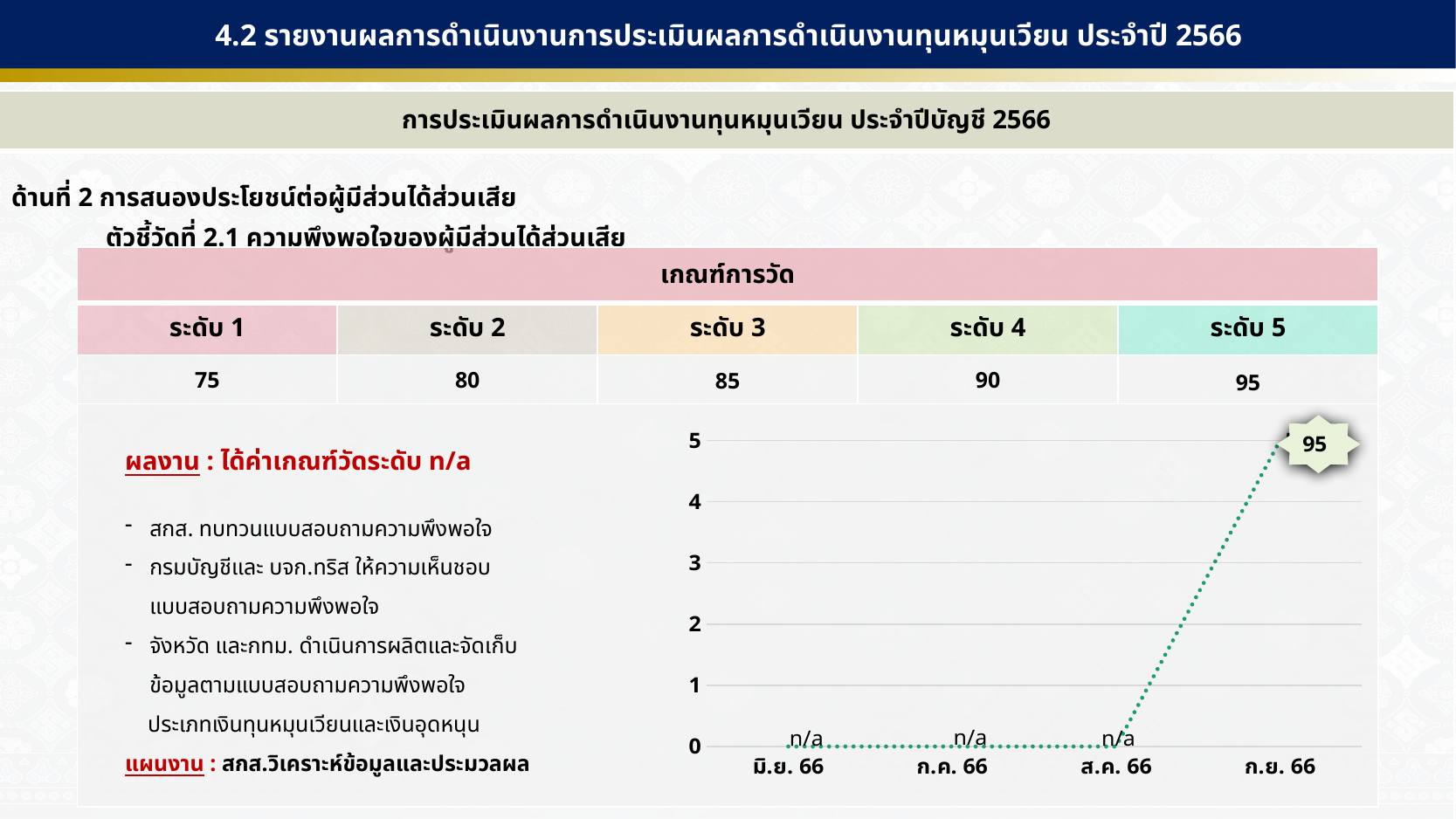
What data label is shown for มิ.ย. 66 in the chart? n/a How many points (months) are plotted along the x axis of the chart? 4 What kind of chart is shown on the slide? line chart What is the first month label on the x axis of the chart? มิ.ย. 66 At which y-axis level does the plotted point for ก.ย. 66 land? 5 Which month has the highest plotted point in the chart? ก.ย. 66 What is the highest tick value shown on the y axis of the chart? 5 Which is higher in the chart, the point for ส.ค. 66 or the point for ก.ย. 66? ก.ย. 66 Is the plotted value for ก.ย. 66 greater or less than 4? greater Does the line rise or fall from ส.ค. 66 to ก.ย. 66? rises What data label is shown for ส.ค. 66 in the chart? n/a What value is shown in the callout at the ก.ย. 66 point of the chart? 95